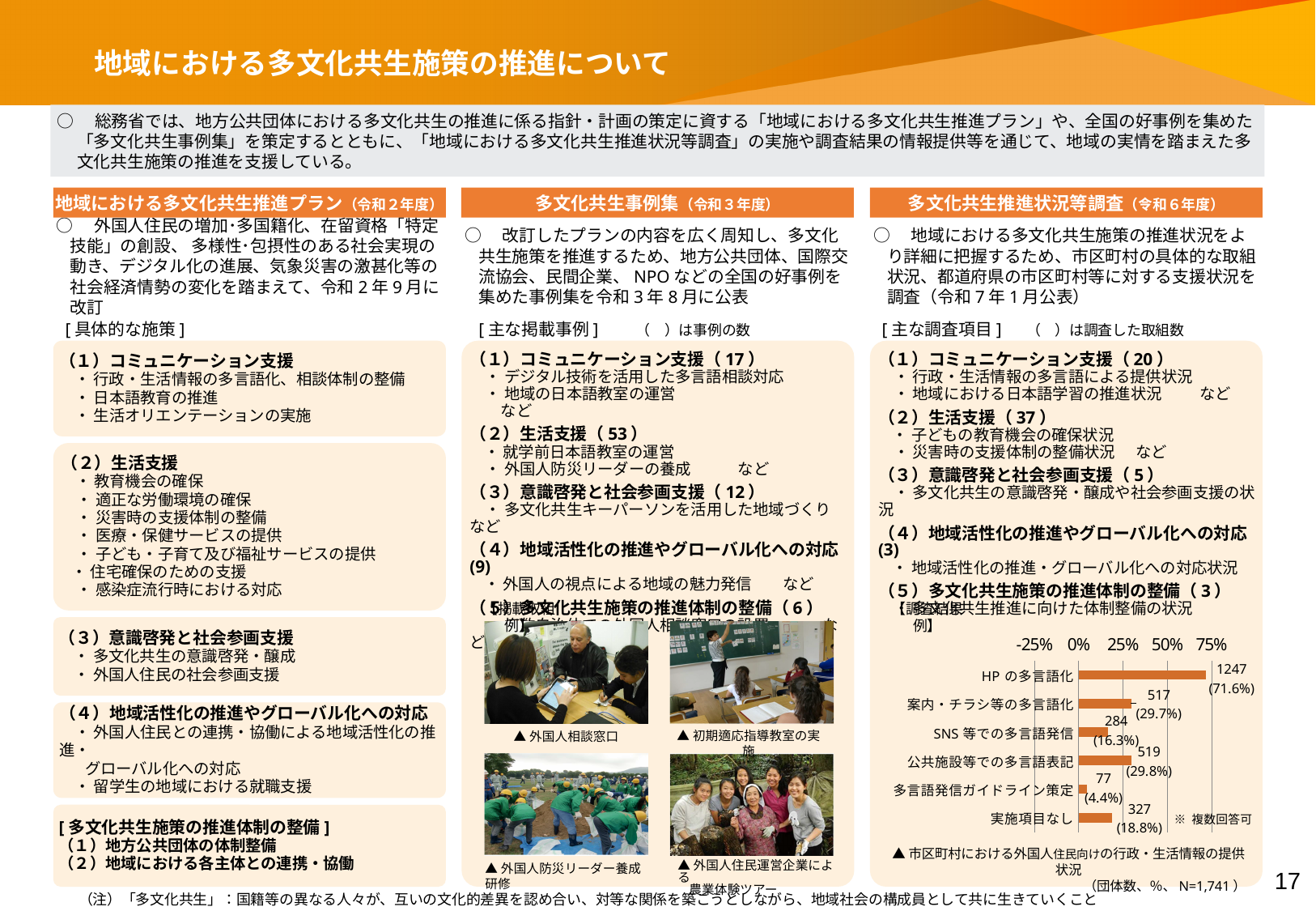
In the bar chart at the bottom right, what is the count shown for 多言語発信ガイドライン策定? 77 In the bar chart at the bottom right, is the value for 公共施設等での多言語表記 greater or less than 50%? less In the bar chart at the bottom right, what is the value for HPの多言語化? 1247 (71.6%) In the bar chart at the bottom right, how many categories are plotted? 6 In the bar chart at the bottom right, which is larger: the value for SNS等での多言語発信 or the value for 実施項目なし? 実施項目なし What is the N (number of organizations) noted for the bar chart at the bottom right? N=1,741 In the bar chart at the bottom right, which category has the lowest value? 多言語発信ガイドライン策定 In the bar chart at the bottom right, which category has the highest value? HPの多言語化 In the bar chart at the bottom right, what is the difference in count between HPの多言語化 and 案内・チラシ等の多言語化? 730 In the bar chart at the bottom right, what percentage is shown for SNS等での多言語発信? 16.3% What kind of chart is shown at the bottom right of the slide (市区町村における外国人住民向けの行政・生活情報の提供状況)? bar chart In the bar chart at the bottom right, what percentage is shown for 実施項目なし? 18.8%